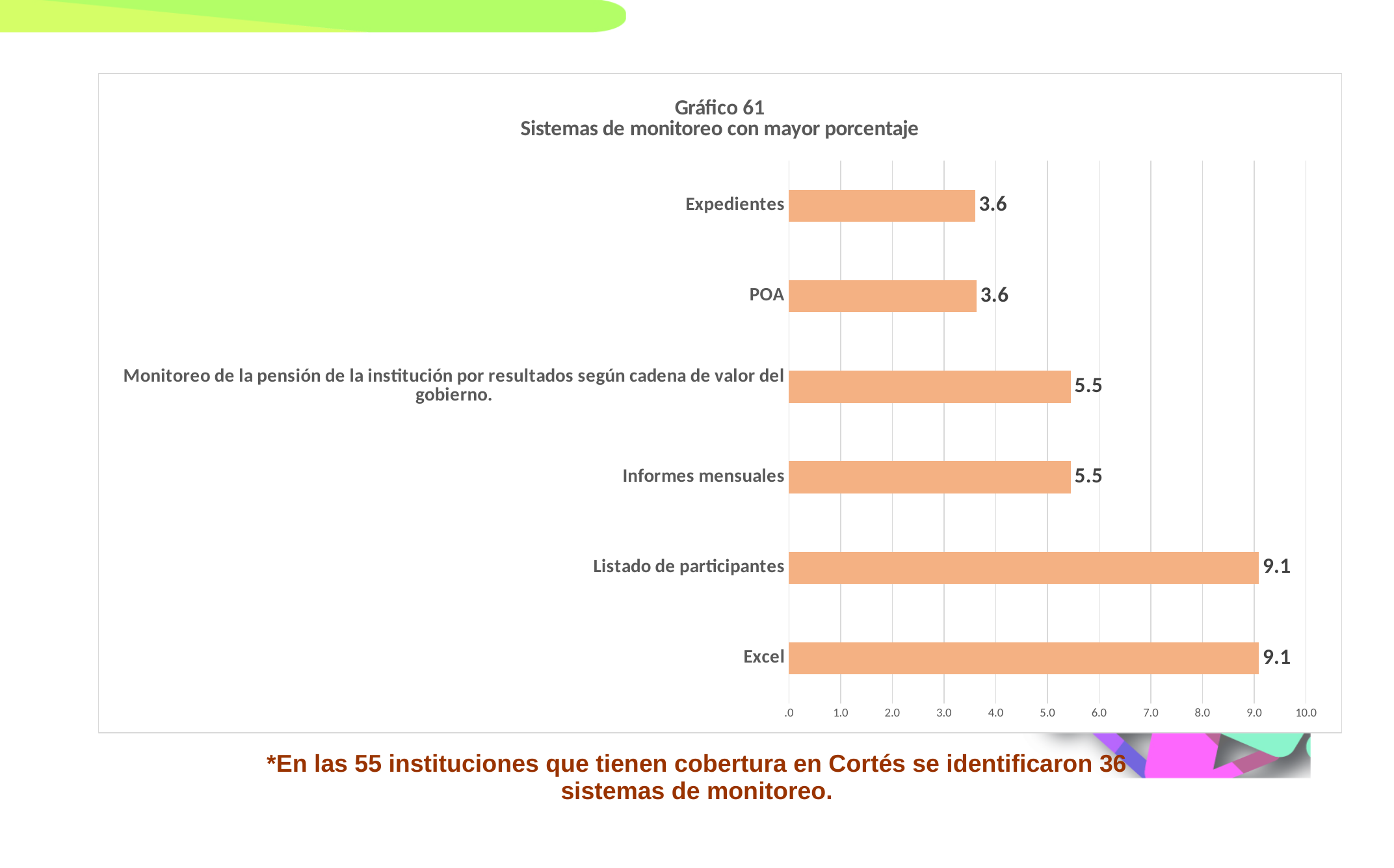
What is the value for POA? 3.6 What kind of chart is shown on the slide? Bar chart What is the value for Informes mensuales? 5.5 What is the value for Expedientes? 3.6 What is the value for Excel? 9.1 Which has a larger value, Listado de participantes or Informes mensuales? Listado de participantes What is the highest value shown in the chart? 9.1 What is the value for Listado de participantes? 9.1 What is the difference between the values for Informes mensuales and POA? 1.9 What is the lowest value shown in the chart? 3.6 How many categories are shown in the chart? 6 What is the difference between the values for Excel and Expedientes? 5.5